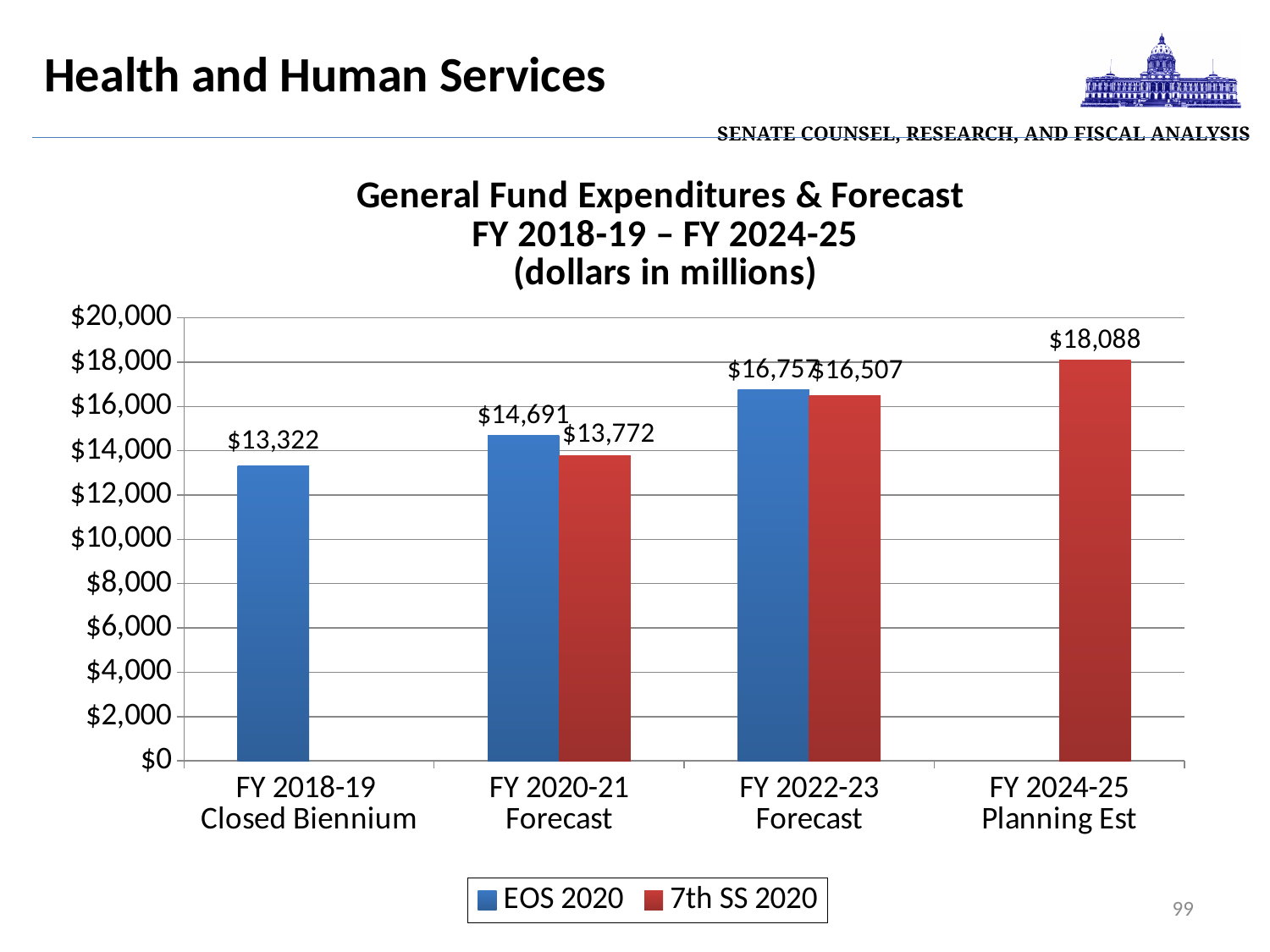
What is the EOS 2020 value for FY 2022-23 Forecast? $16,757 What kind of chart is shown on the slide? bar chart How many categories are shown on the x axis? 4 For FY 2022-23 Forecast, which series has the larger value, EOS 2020 or 7th SS 2020? EOS 2020 What is the difference between the EOS 2020 and 7th SS 2020 values for FY 2020-21 Forecast? $919 What is the 7th SS 2020 value for FY 2020-21 Forecast? $13,772 Which category has the highest 7th SS 2020 value? FY 2024-25 Planning Est Which category has the lowest EOS 2020 value? FY 2018-19 Closed Biennium What is the EOS 2020 value for FY 2018-19 Closed Biennium? $13,322 How many series does the legend list? 2 What is the 7th SS 2020 value for FY 2024-25 Planning Est? $18,088 Is the 7th SS 2020 value for FY 2024-25 Planning Est greater or less than $18,000? greater